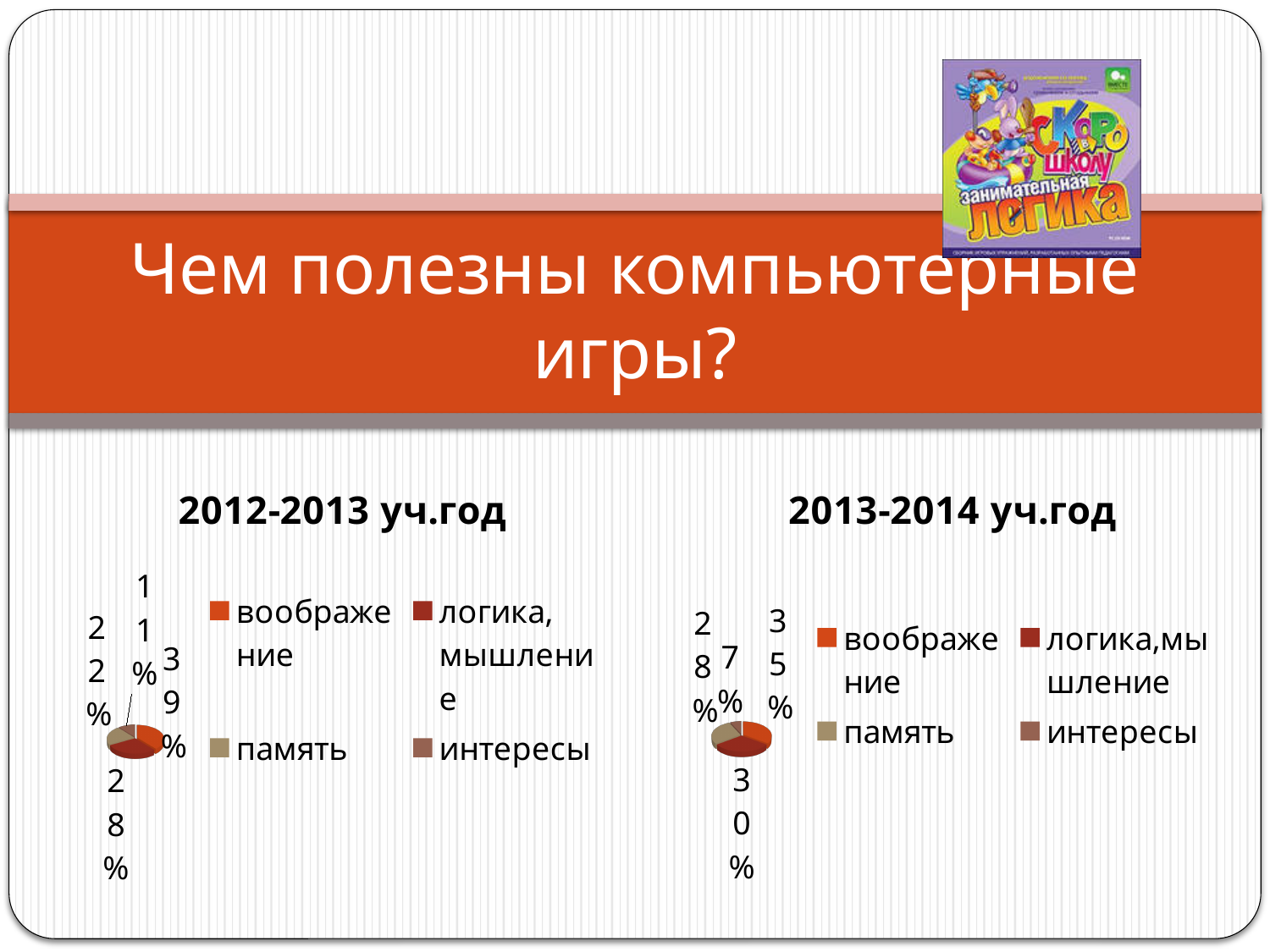
What kind of chart is used for the 2013-2014 уч.год data? pie chart Which legend entries are listed on the 2013-2014 уч.год chart? воображение, логика,мышление, память, интересы How many entries does the legend of the 2012-2013 уч.год chart list? 4 What is the title of the chart on the left side of the slide? 2012-2013 уч.год What is the smallest percentage shown on the 2013-2014 уч.год chart? 7% On the 2013-2014 уч.год chart, what is the difference between the largest and smallest percentages shown? 28% What is the largest percentage shown on the 2012-2013 уч.год chart? 39% What is the smallest percentage shown on the 2012-2013 уч.год chart? 11% What kind of chart is used for the 2012-2013 уч.год data? pie chart How many slices does the 2013-2014 уч.год pie chart have? 4 On the 2012-2013 уч.год chart, what is the difference between the largest and smallest percentages shown? 28% What is the largest percentage shown on the 2013-2014 уч.год chart? 35%